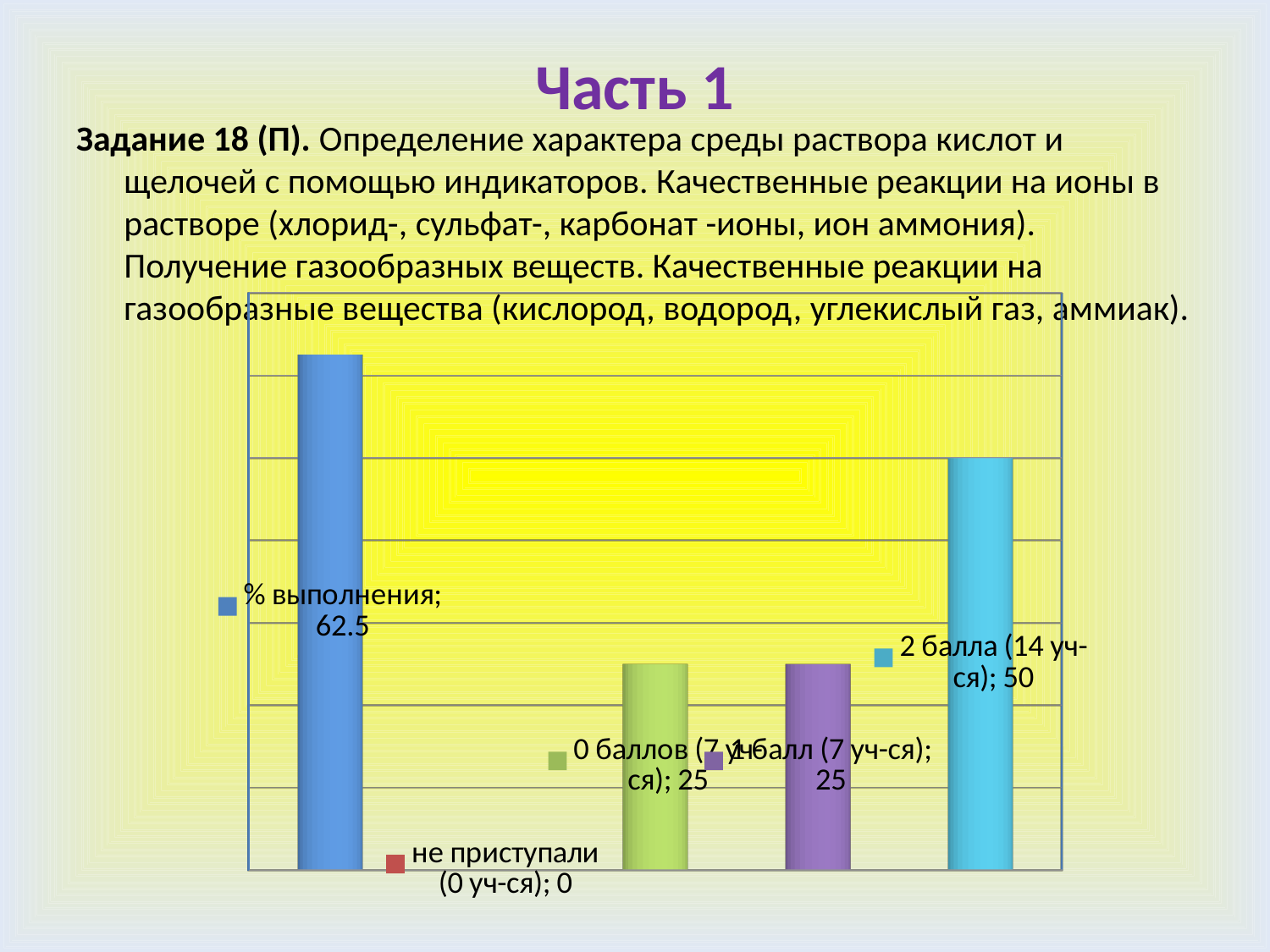
What is the value for "% выполнения"? 62.5 What is the value for "не приступали (0 уч-ся)"? 0 What is the value for "0 баллов (7 уч-ся)"? 25 What kind of chart is shown on the slide? bar chart Which category has the lowest value? не приступали (0 уч-ся) What is the value for "2 балла (14 уч-ся)"? 50 What is the title of the slide? Часть 1 Which is larger: the value for "2 балла (14 уч-ся)" or the value for "1 балл (7 уч-ся)"? 2 балла (14 уч-ся) What is the difference between the value for "2 балла (14 уч-ся)" and the value for "0 баллов (7 уч-ся)"? 25 How many bars (categories) does the chart show? 5 What is the difference between the value for "% выполнения" and the value for "2 балла (14 уч-ся)"? 12.5 Which category has the highest value? % выполнения